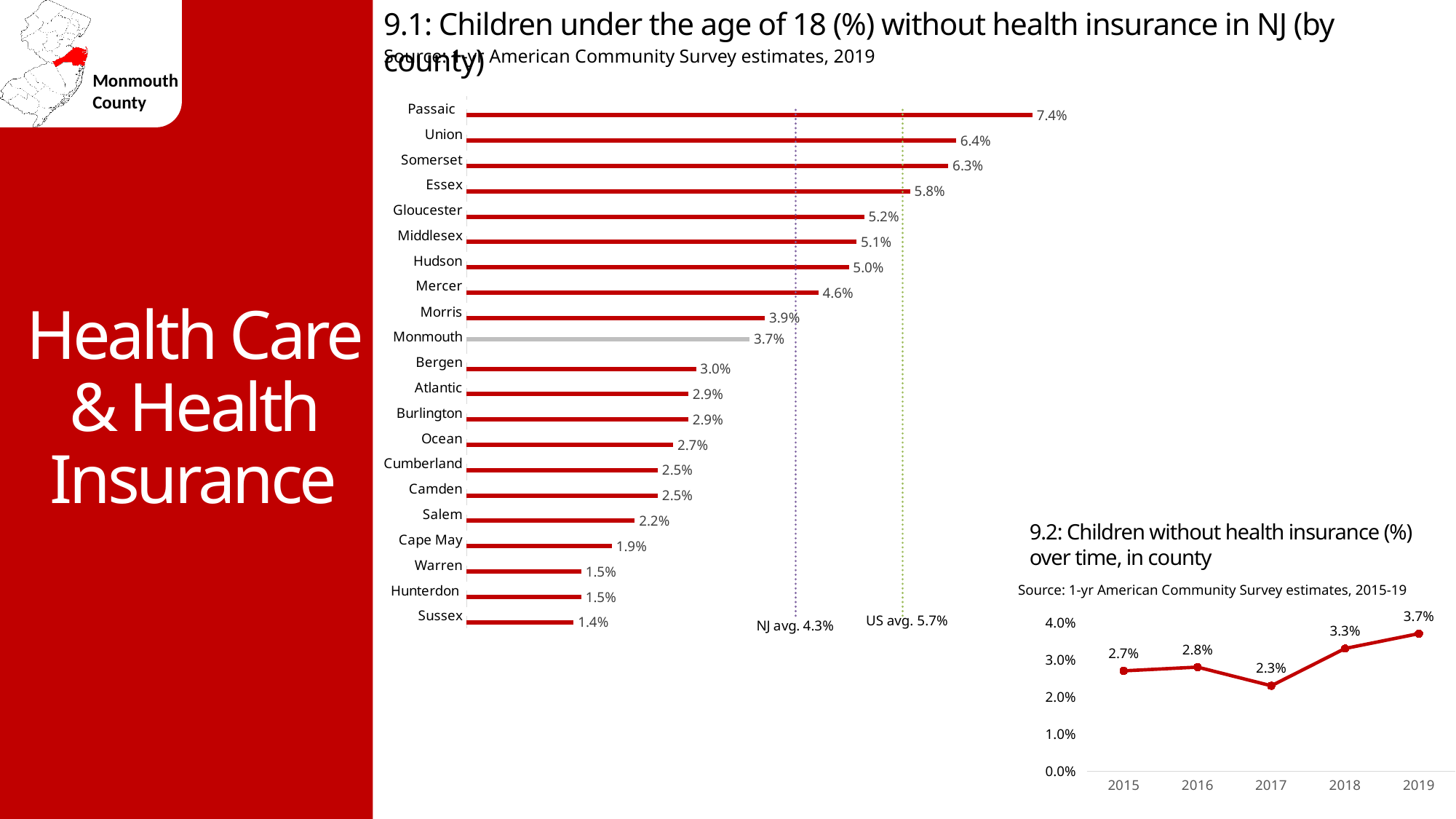
In chart 9.1, which county has the highest percentage of children without health insurance? Passaic In chart 9.1, which county has the lowest percentage of children without health insurance? Sussex In chart 9.1, what is the NJ average shown by the dotted reference line? 4.3% In chart 9.1, how many counties are shown? 21 In chart 9.2, what is the difference between the 2019 and 2015 values? 1.0% What kind of chart is chart 9.2? Line chart In chart 9.1, which county has a higher value, Union or Somerset? Union What kind of chart is chart 9.1? Bar chart In chart 9.2, which year has the highest value? 2019 In chart 9.1, what is the difference between the values for Passaic and Sussex? 6.0% In chart 9.2 (children without health insurance over time), what is the value for 2017? 2.3% In chart 9.1 (children under 18 without health insurance by county), what is the value for Monmouth? 3.7%